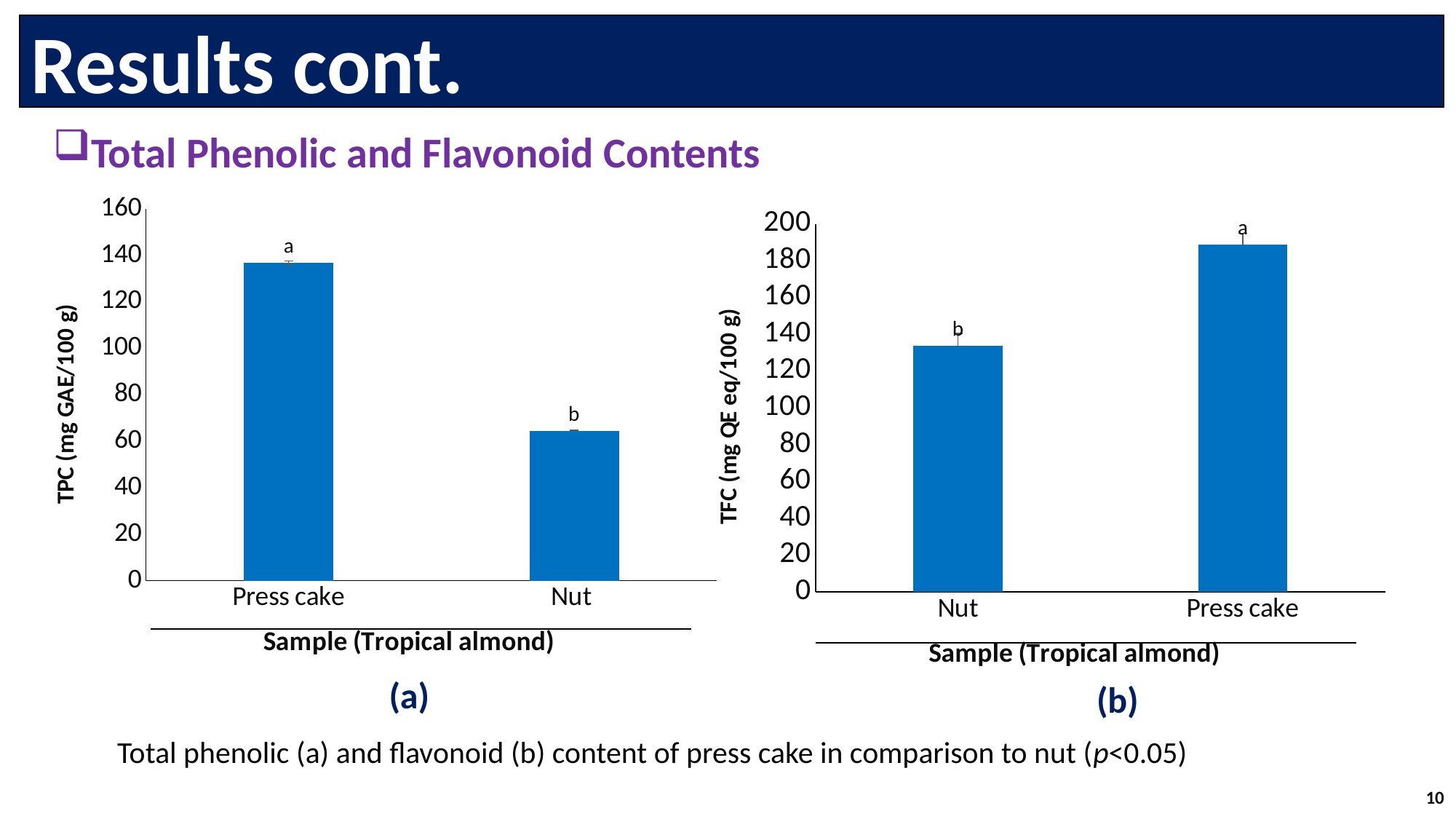
What is the y-axis label of chart (a)? TPC (mg GAE/100 g) In chart (b), is the TFC value for Nut greater or less than 120? greater In chart (a), is the TPC value for Nut greater or less than 80? less In chart (b), which sample has the higher TFC value? Press cake What kind of chart is chart (b)? Bar chart In chart (a), is the TPC value for Press cake greater or less than 120? greater How many samples are plotted in chart (a)? 2 In chart (a), which sample has the higher TPC value? Press cake In chart (a), which sample has the lower TPC value? Nut In chart (b), which sample has the lower TFC value? Nut